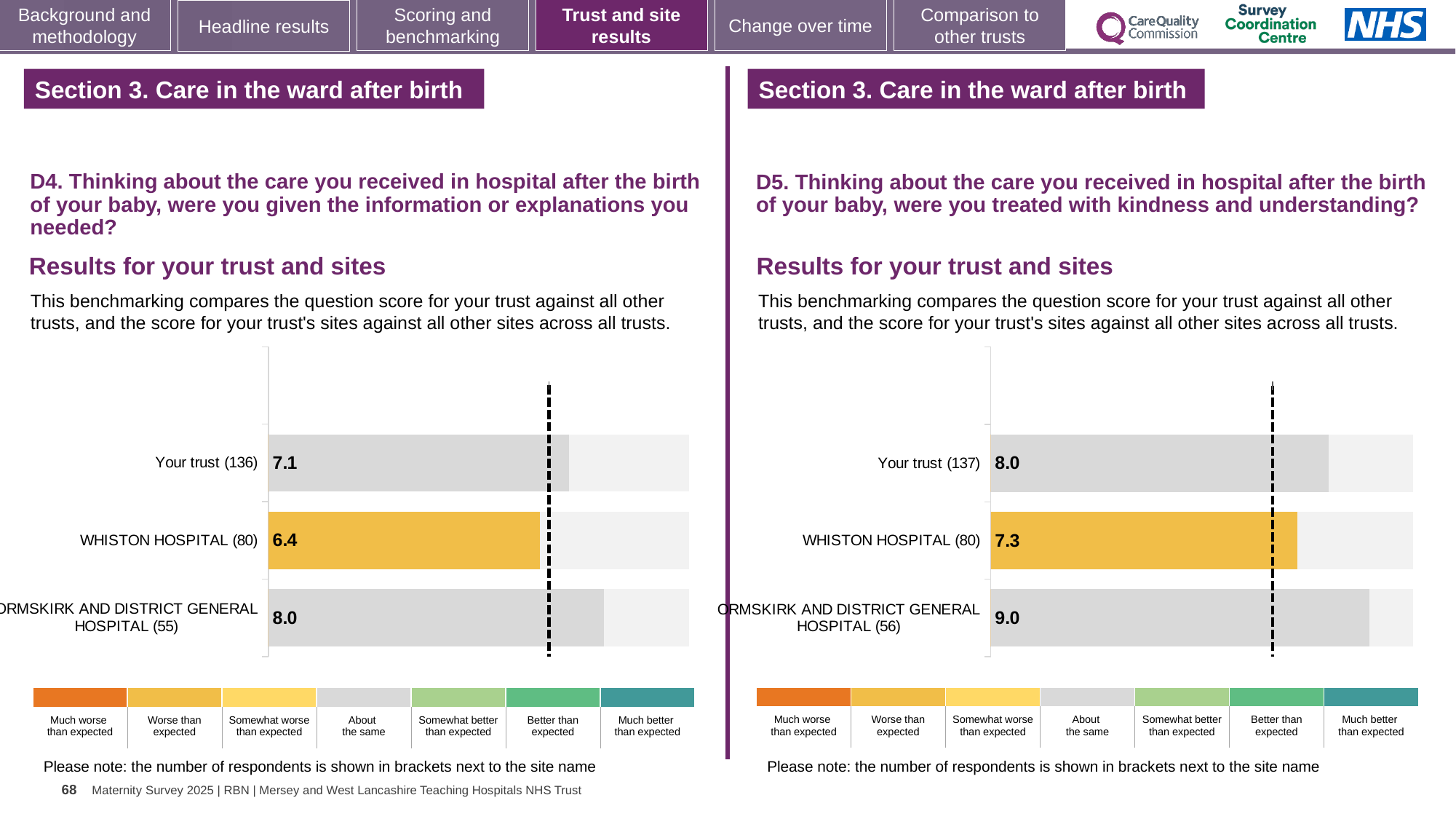
In the right chart (D5), what is the score for Ormskirk and District General Hospital? 9.0 In the right chart (D5), what is the difference between the scores for Your trust and Whiston Hospital? 0.7 In the right chart (D5), what is the score for Whiston Hospital? 7.3 In the right chart (D5), how many respondents are shown in brackets for Your trust? 137 What type of chart is used in the left chart (D4)? Bar chart How many bars are plotted in the right chart (D5)? 3 In the left chart (D4), which site or trust has the highest score? Ormskirk and District General Hospital In the left chart (D4), what is the score for Your trust? 7.1 In the left chart (D4), which site or trust has the lowest score? Whiston Hospital In the right chart (D5), which is larger, the score for Your trust or the score for Whiston Hospital? Your trust In the left chart (D4), what is the difference between the scores for Ormskirk and District General Hospital and Whiston Hospital? 1.6 In the left chart (D4), what is the score for Whiston Hospital? 6.4